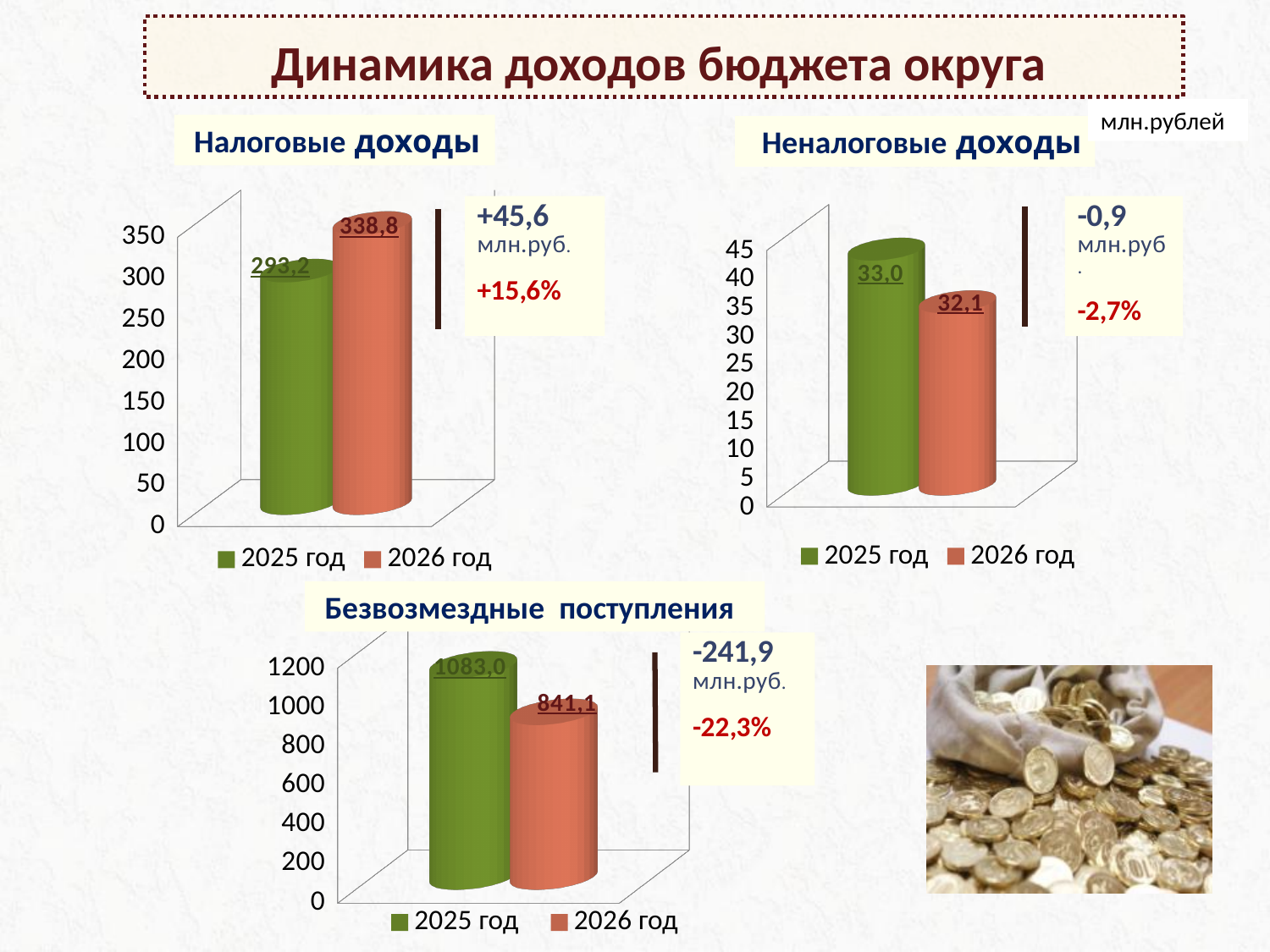
In the 'Налоговые доходы' chart, what is the value for 2026 год? 338,8 In the 'Безвозмездные поступления' chart, what is the value for 2025 год? 1083,0 In the 'Безвозмездные поступления' chart, what is the difference between the 2025 год and 2026 год values? 241,9 How many series does the legend of the 'Неналоговые доходы' chart list? 2 In the 'Налоговые доходы' chart, which year has the higher value? 2026 год In the 'Неналоговые доходы' chart, what is the value for 2025 год? 33,0 In the 'Безвозмездные поступления' chart, which year has the lowest value? 2026 год In the 'Налоговые доходы' chart, what is the difference between the 2026 год and 2025 год values? 45,6 In the 'Налоговые доходы' chart, what is the value for 2025 год? 293,2 What kind of chart is the 'Безвозмездные поступления' chart? Bar chart In the 'Неналоговые доходы' chart, what is the value for 2026 год? 32,1 In the 'Безвозмездные поступления' chart, what is the value for 2026 год? 841,1